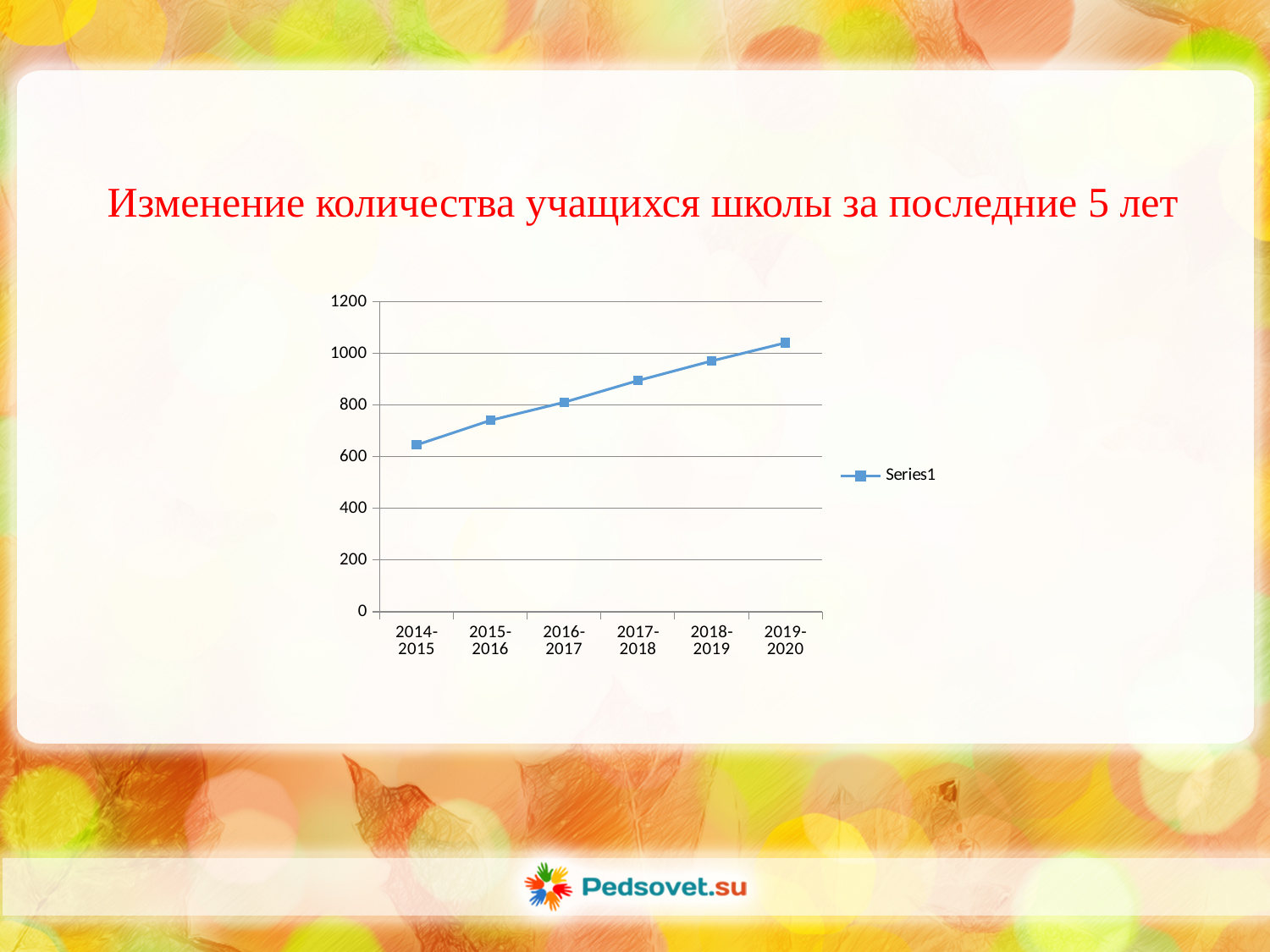
Which is larger, the value for 2017-2018 or the value for 2015-2016? 2017-2018 Which school year has the highest value? 2019-2020 Do the values rise or fall from 2014-2015 to 2019-2020? rise How many school years are plotted on the x axis? 6 What is the title of the slide above the chart? Изменение количества учащихся школы за последние 5 лет Is the value for 2019-2020 greater or less than 1000? greater What type of chart is shown on the slide? line chart Is the value for 2015-2016 greater or less than 800? less How many series does the legend list? 1 Which school year has the lowest value? 2014-2015 What is the name of the series shown in the legend? Series1 Is the value for 2014-2015 greater or less than 600? greater